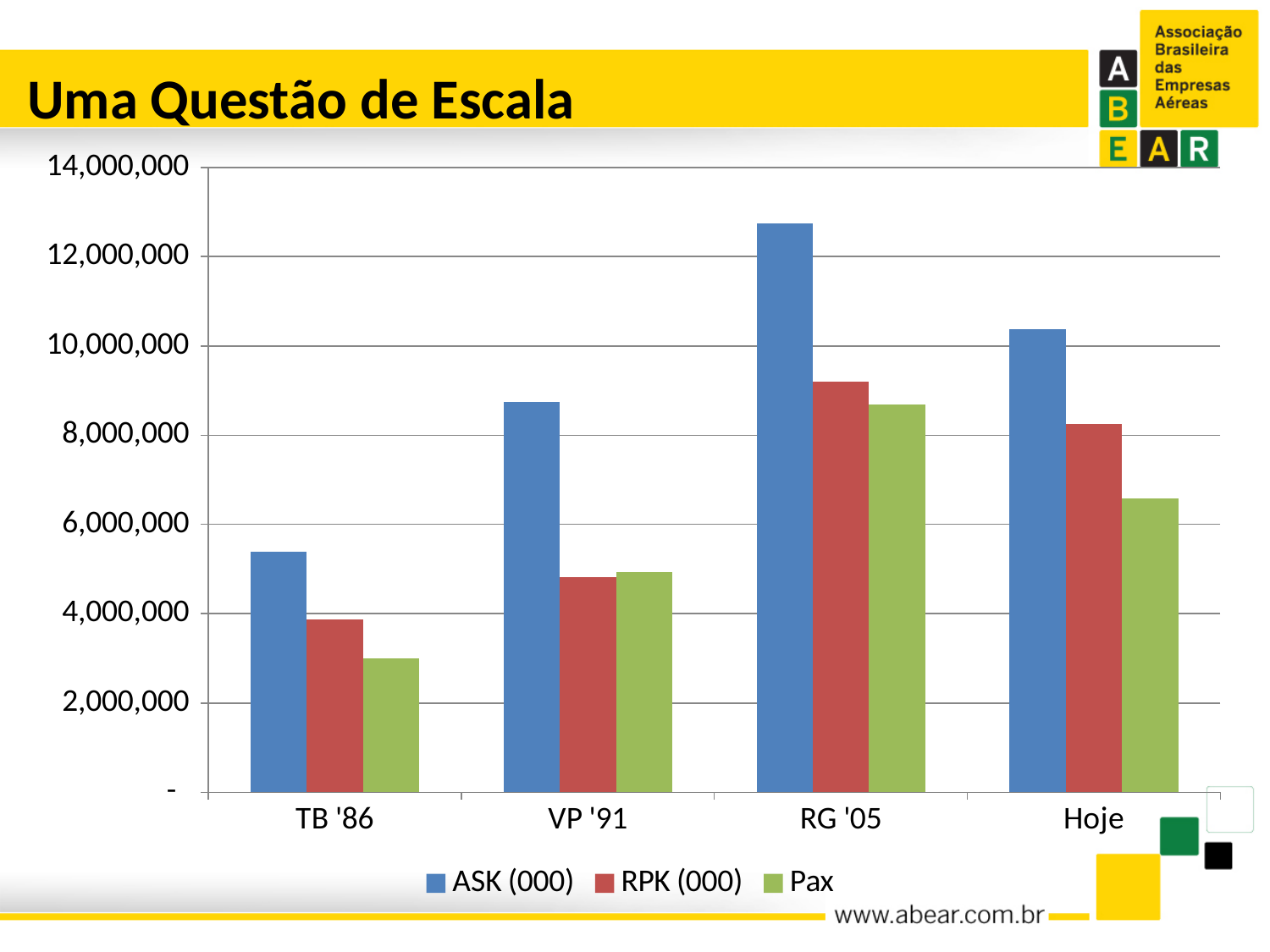
Is the ASK (000) value for RG '05 larger or smaller than the ASK (000) value for Hoje? larger Which category has the lowest Pax value? TB '86 Which category has the lowest ASK (000) value? TB '86 Is the ASK (000) value for RG '05 greater or less than 12,000,000? greater What is the title of the slide containing the chart? Uma Questão de Escala What kind of chart is shown on the slide? bar chart How many categories are shown on the x axis of the chart? 4 Does the ASK (000) value rise or fall from TB '86 to RG '05? rise Is the Pax value for Hoje greater or less than 8,000,000? less Is the Pax value for TB '86 greater or less than 4,000,000? less Which category has the highest ASK (000) value? RG '05 How many series does the chart legend list? 3